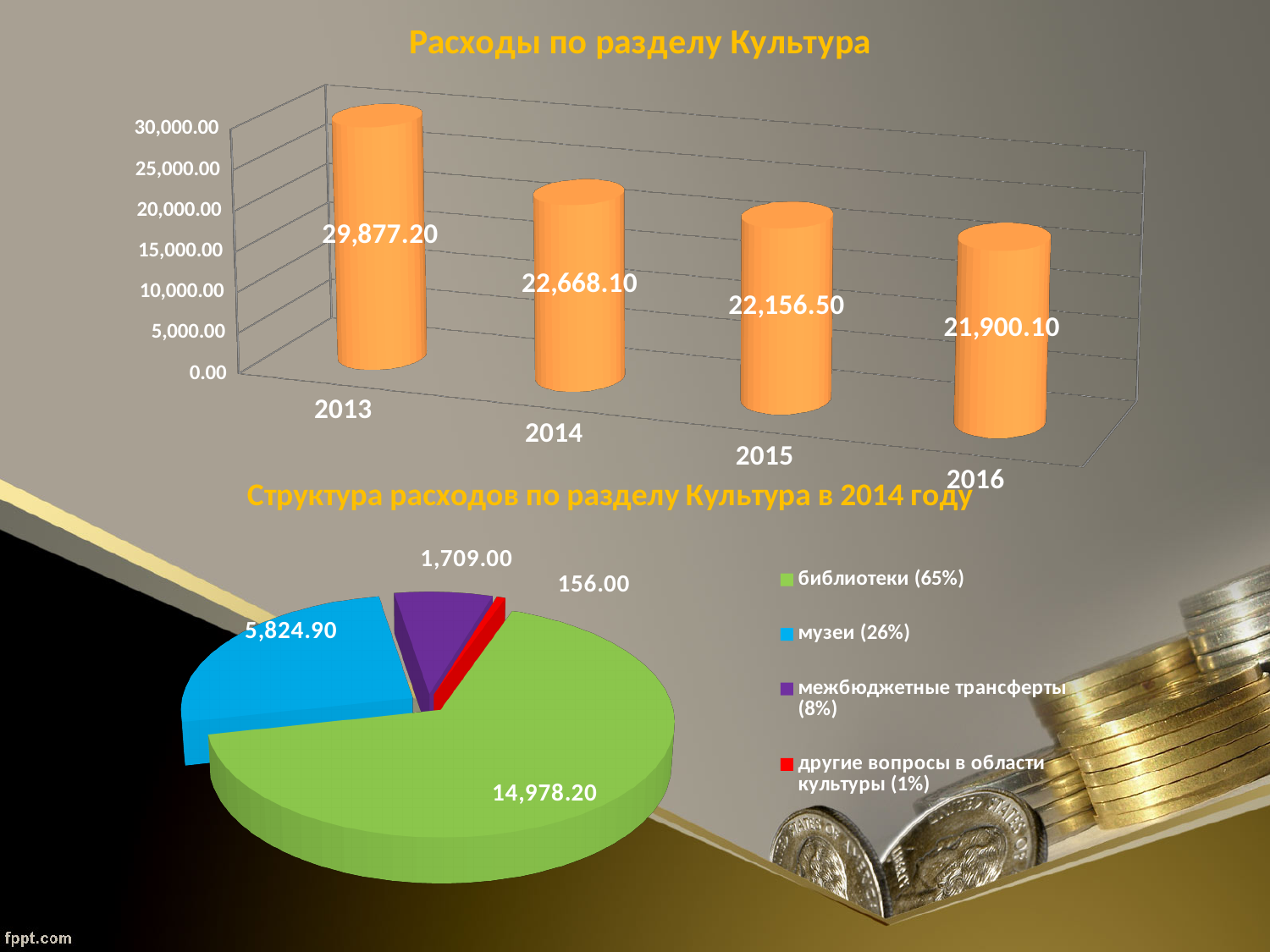
In the chart 'Расходы по разделу Культура', what is the value for 2016? 21,900.10 In the chart 'Расходы по разделу Культура', which year has the highest value? 2013 In the pie chart 'Структура расходов по разделу Культура в 2014 году', what is the value for музеи? 5,824.90 In the chart 'Расходы по разделу Культура', how many years are shown? 4 In the chart 'Расходы по разделу Культура', what is the value for 2013? 29,877.20 How many entries does the legend of the pie chart 'Структура расходов по разделу Культура в 2014 году' list? 4 In the pie chart 'Структура расходов по разделу Культура в 2014 году', what share of the pie do библиотеки have? 65% What kind of chart is 'Расходы по разделу Культура'? bar chart In the chart 'Расходы по разделу Культура', what is the difference between the values for 2013 and 2014? 7,209.10 In the chart 'Расходы по разделу Культура', which year has the lowest value? 2016 In the pie chart 'Структура расходов по разделу Культура в 2014 году', which category has the smallest slice? другие вопросы в области культуры In the chart 'Расходы по разделу Культура', do the values rise or fall from 2013 to 2016? fall